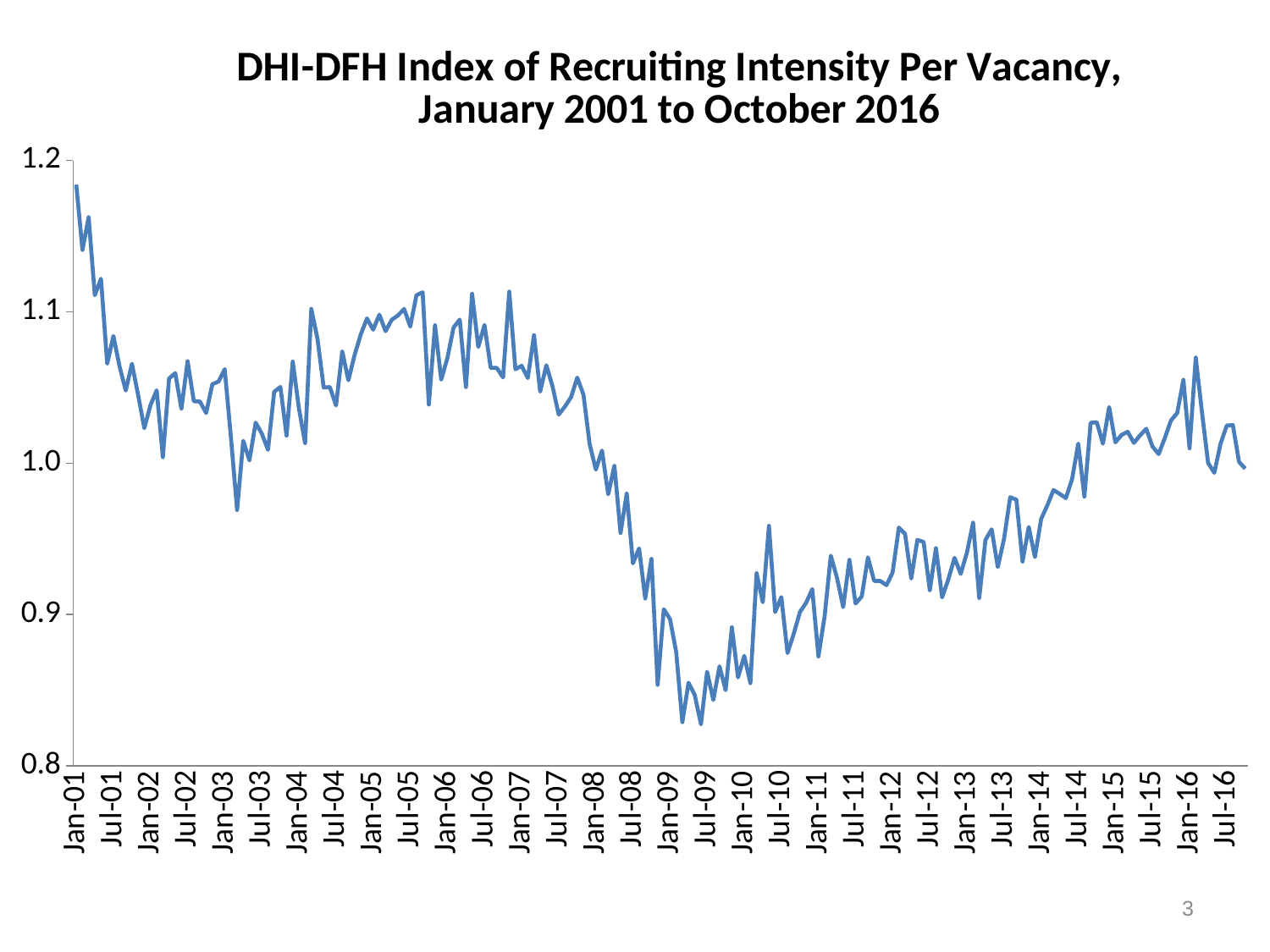
Is the value at Jul-09 greater or less than 0.9? less What kind of chart is shown on the slide? line chart Around which x-axis label does the index reach its highest point? Jan-01 What is the title of the chart? DHI-DFH Index of Recruiting Intensity Per Vacancy, January 2001 to October 2016 Is the value at Jul-12 greater or less than 1.0? less Is the value at Jan-01 greater or less than 1.1? greater Around which x-axis label does the index reach its lowest point? Jul-09 Does the index rise or fall overall between Jul-09 and Jan-16? rise Does the index rise or fall between Jan-08 and Jul-09? fall